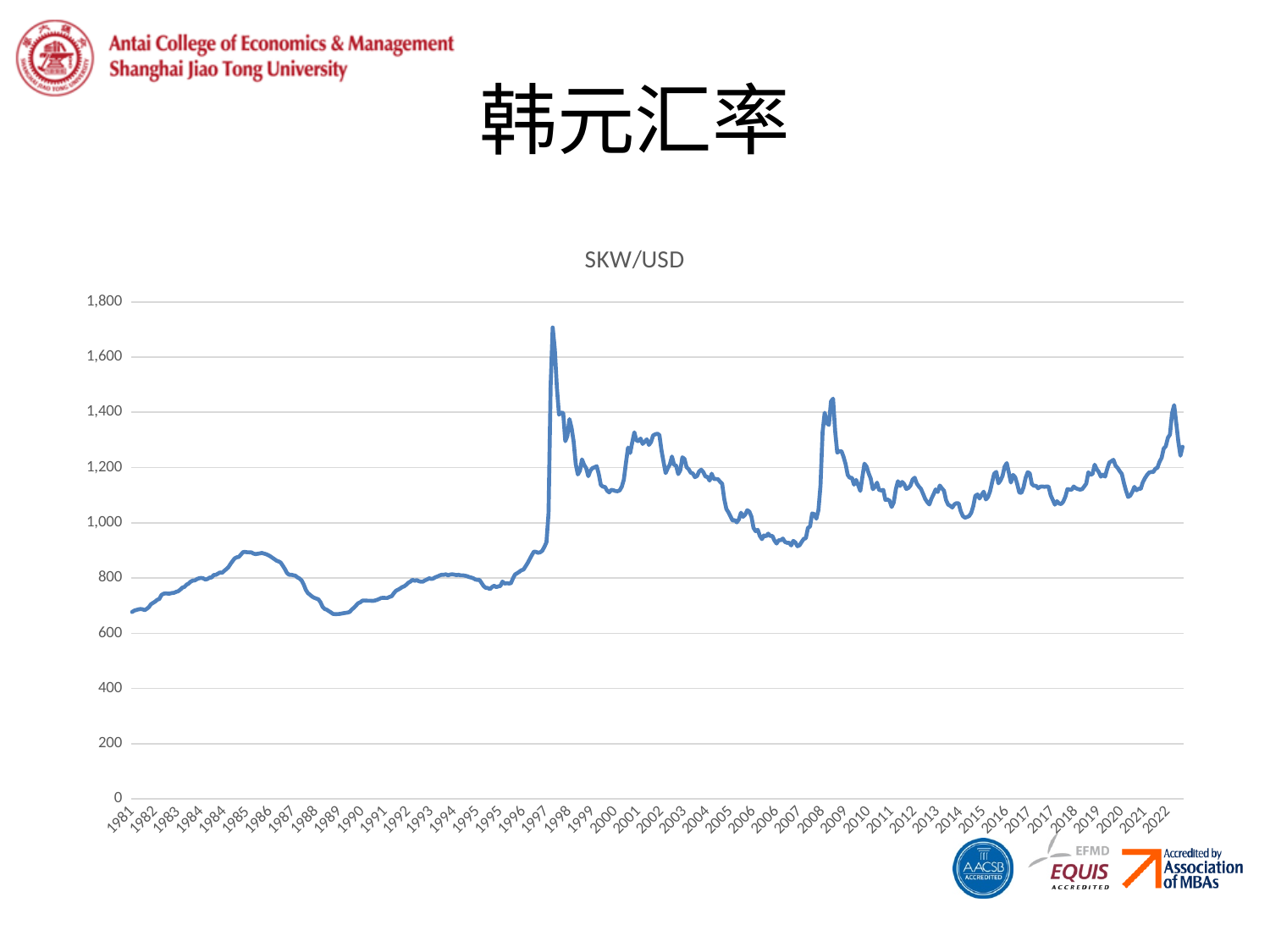
What is the title of the chart? SKW/USD What is the highest value shown on the y axis of the chart? 1,800 Is the value at the highest peak of the line greater or less than 1,600? greater Is the value for 1989 greater or less than 800? less Does the value rise or fall from 1981 to 1985? rise What kind of chart is shown on the slide? line chart Is the value for 1981 greater or less than 800? less Does the value rise or fall from 2005 to 2007? fall Which is larger, the value for 1981 or the value for 2022? 2022 Does the highest peak of the line occur before or after 2000? before